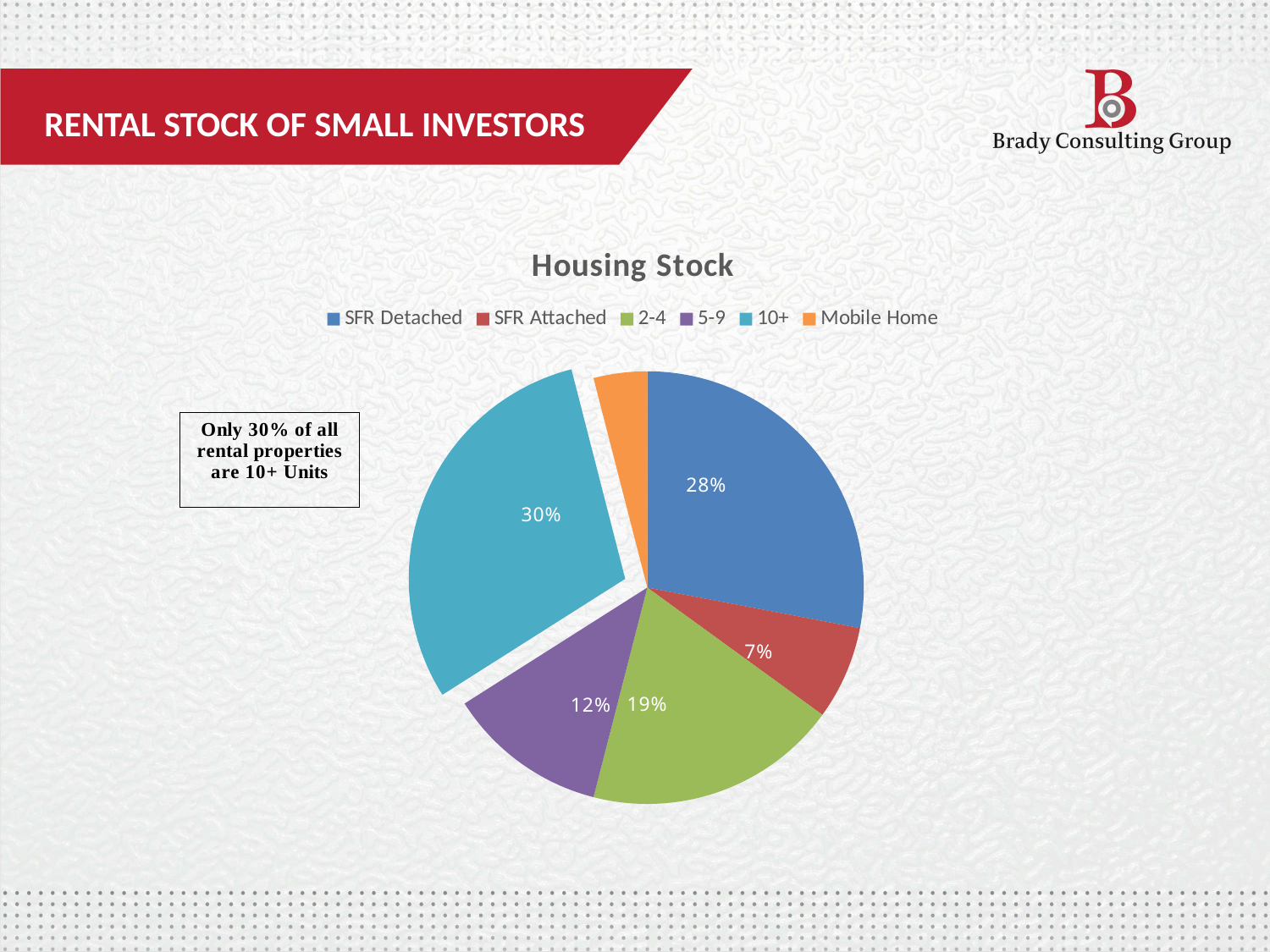
How many categories does the legend of the Housing Stock pie chart list? 6 What is the difference in percentage points between the 2-4 slice and the 5-9 slice? 7 What share of the Housing Stock pie is 10+? 30% What share of the Housing Stock pie is 5-9? 12% What type of chart is shown on the slide? pie chart Which is larger in the Housing Stock pie chart, the 2-4 slice or the SFR Attached slice? 2-4 What share of the Housing Stock pie is SFR Attached? 7% What is the title of the chart? Housing Stock Which category has the smallest slice in the Housing Stock pie chart? Mobile Home Which category has the largest slice in the Housing Stock pie chart? 10+